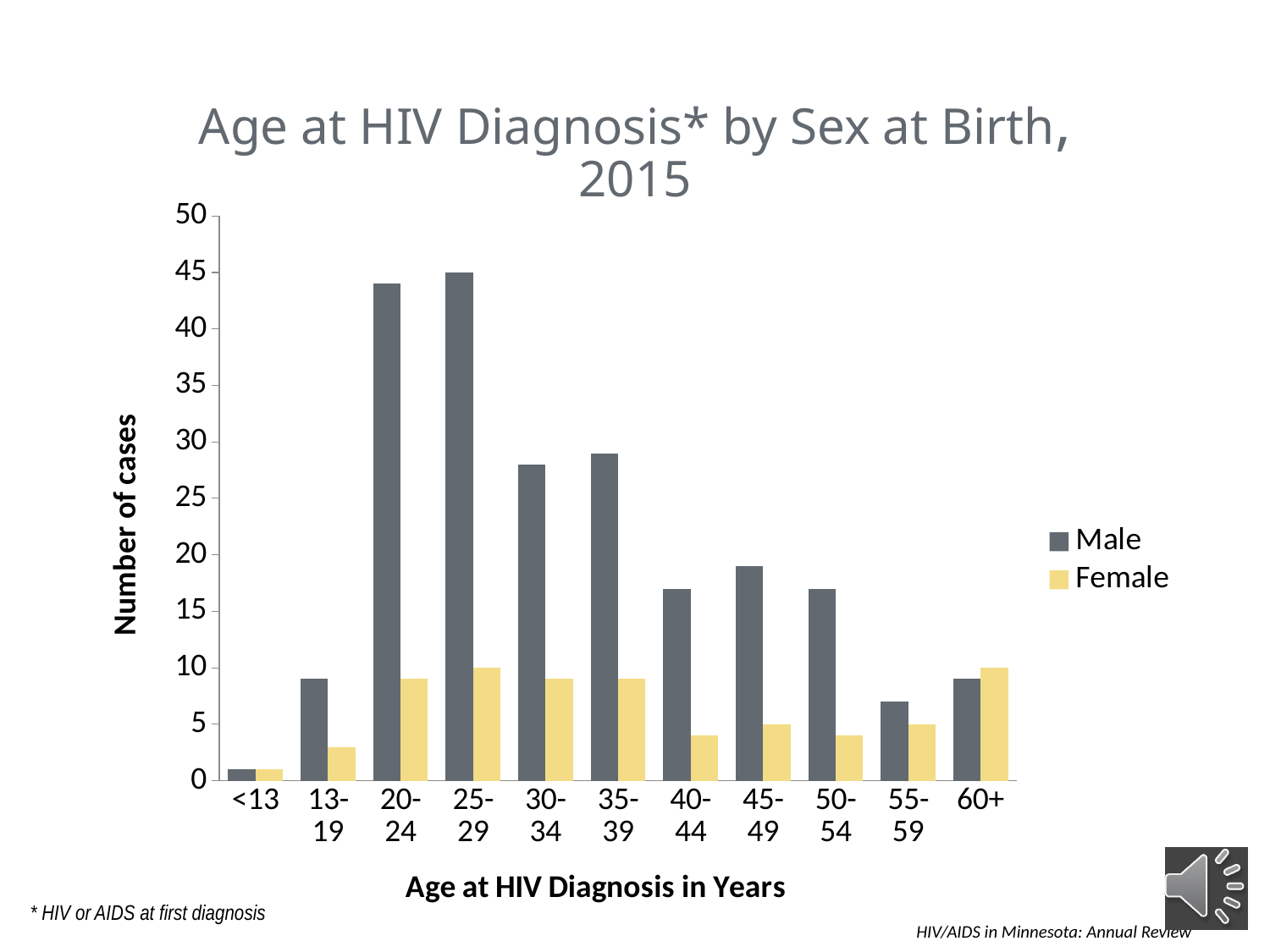
In the 35-39 age group, which series has the larger value, Male or Female? Male What is the title of the y axis? Number of cases Which age group has the lowest number of Female cases? <13 Which age group has the lowest number of Male cases? <13 Which is larger, the Male value for 30-34 or the Male value for 45-49? Male value for 30-34 Is the Male value for the 30-34 age group greater or less than 25? greater Do the Male bars rise or fall from the 25-29 age group to the 40-44 age group? fall How many series does the legend list? 2 What kind of chart is shown on the slide? bar chart How many age categories are shown on the x axis? 11 Is the Female value for the 13-19 age group greater or less than 5? less Is the Male value for the 40-44 age group greater or less than 20? less